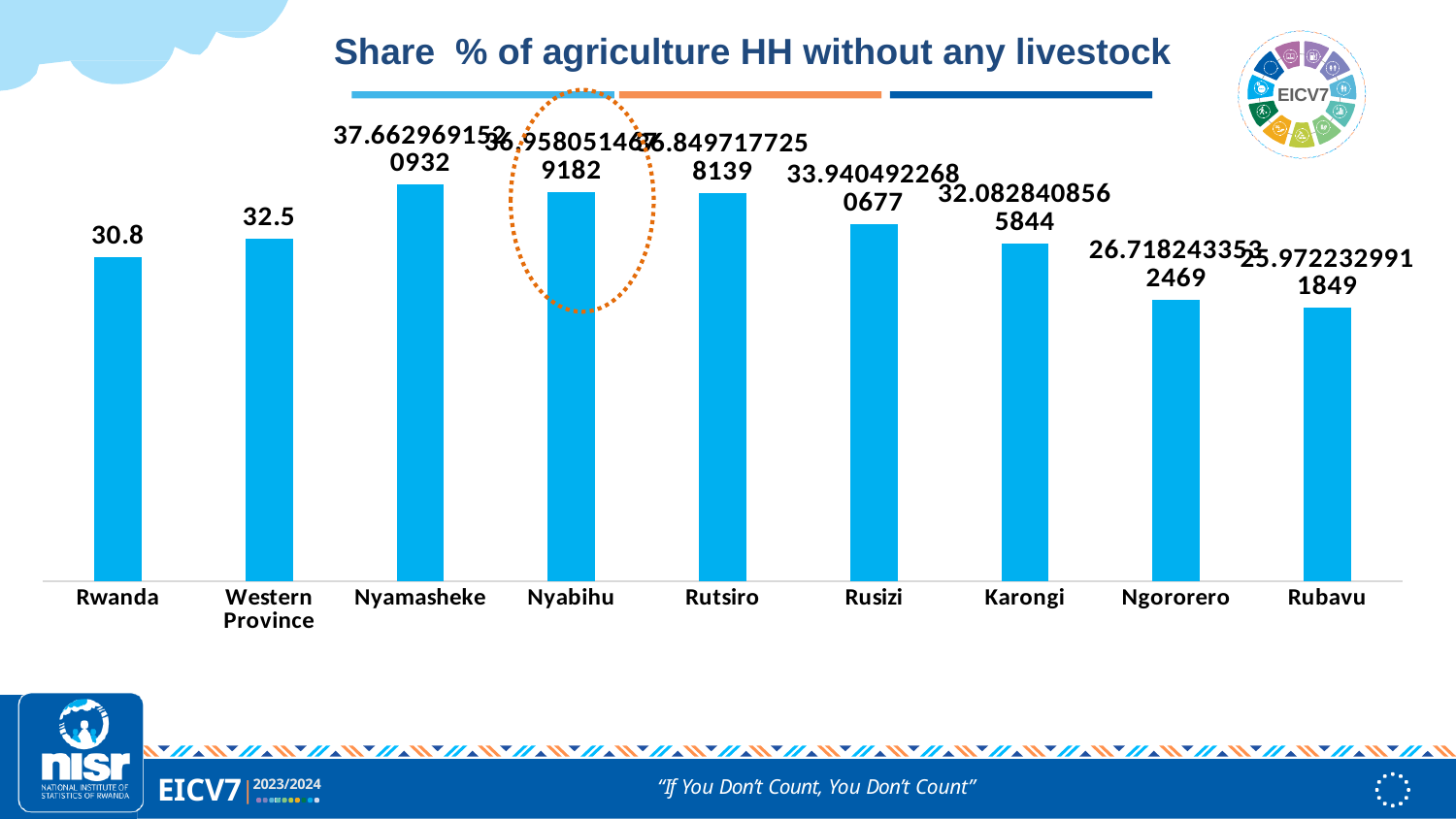
Do the values rise or fall from Nyamasheke to Rubavu along the x axis? Fall How many categories are shown on the x axis? 9 Which category's bar is highlighted with a dotted orange circle? Nyabihu What is the value for Western Province? 32.5 Which is larger, the value for Nyamasheke or the value for Rwanda? Nyamasheke What kind of chart is shown on the slide? Bar chart What is the difference between the values for Western Province and Rwanda? 1.7 What is the value for Rwanda? 30.8 Which category has the highest share of agriculture households without any livestock? Nyamasheke Which is larger, the value for Western Province or the value for Ngororero? Western Province Which category has the lowest share of agriculture households without any livestock? Rubavu Which is larger, the value for Rusizi or the value for Karongi? Rusizi